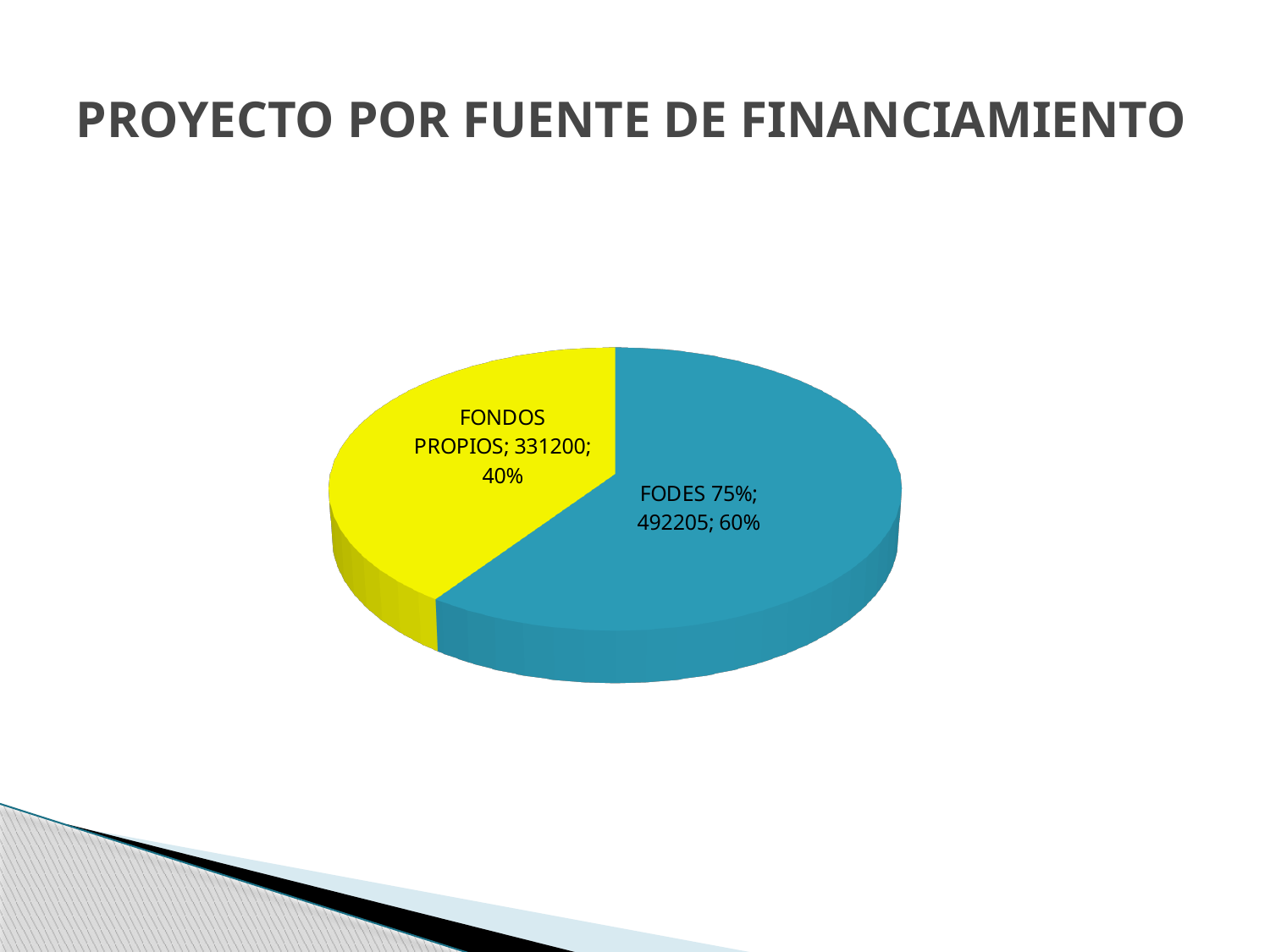
What is the total of the two slice values? 823405 Which is larger, FODES 75% or FONDOS PROPIOS? FODES 75% What is the value for FODES 75%? 492205 What share of the pie does FONDOS PROPIOS represent? 40% What is the title of the slide? PROYECTO POR FUENTE DE FINANCIAMIENTO What kind of chart is shown on the slide? Pie chart Which slice is the smallest? FONDOS PROPIOS How many slices does the pie chart have? 2 What is the difference between the FODES 75% value and the FONDOS PROPIOS value? 161005 What is the value for FONDOS PROPIOS? 331200 Which slice is the largest? FODES 75% What share of the pie does FODES 75% represent? 60%